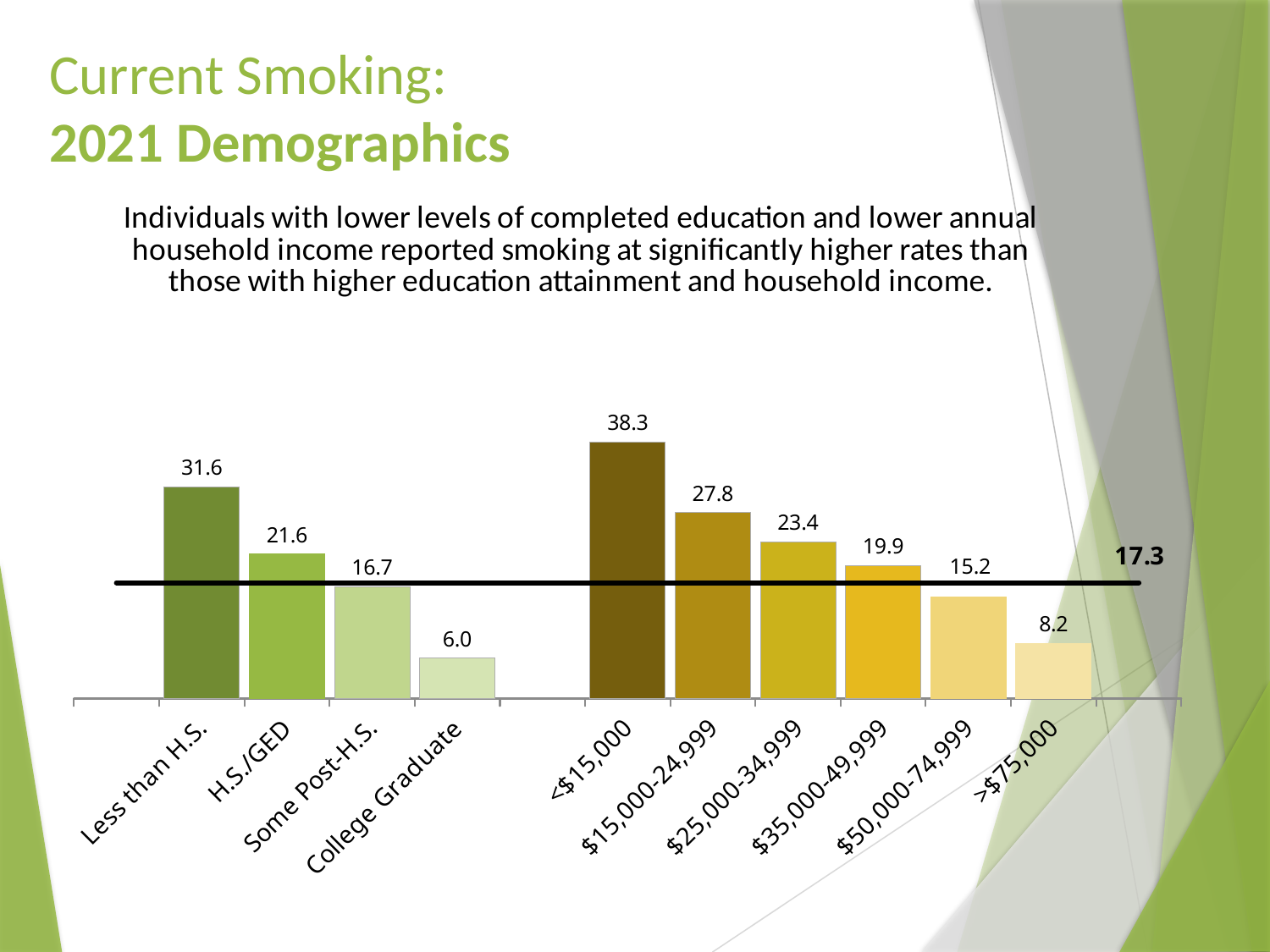
What kind of chart is shown on the slide? Bar chart What is the difference between the values for <$15,000 and >$75,000? 30.1 What is the value for Less than H.S.? 31.6 What is the difference between the values for Less than H.S. and College Graduate? 25.6 How many income categories are shown on the chart? 6 Which category has the lowest value on the chart? College Graduate How many bars are plotted on the chart in total? 10 What is the value for the <$15,000 income category? 38.3 What is the value for $50,000-74,999? 15.2 Which category has the highest value on the chart? <$15,000 What value is marked by the horizontal line across the chart? 17.3 Which is larger, the value for H.S./GED or the value for $25,000-34,999? $25,000-34,999